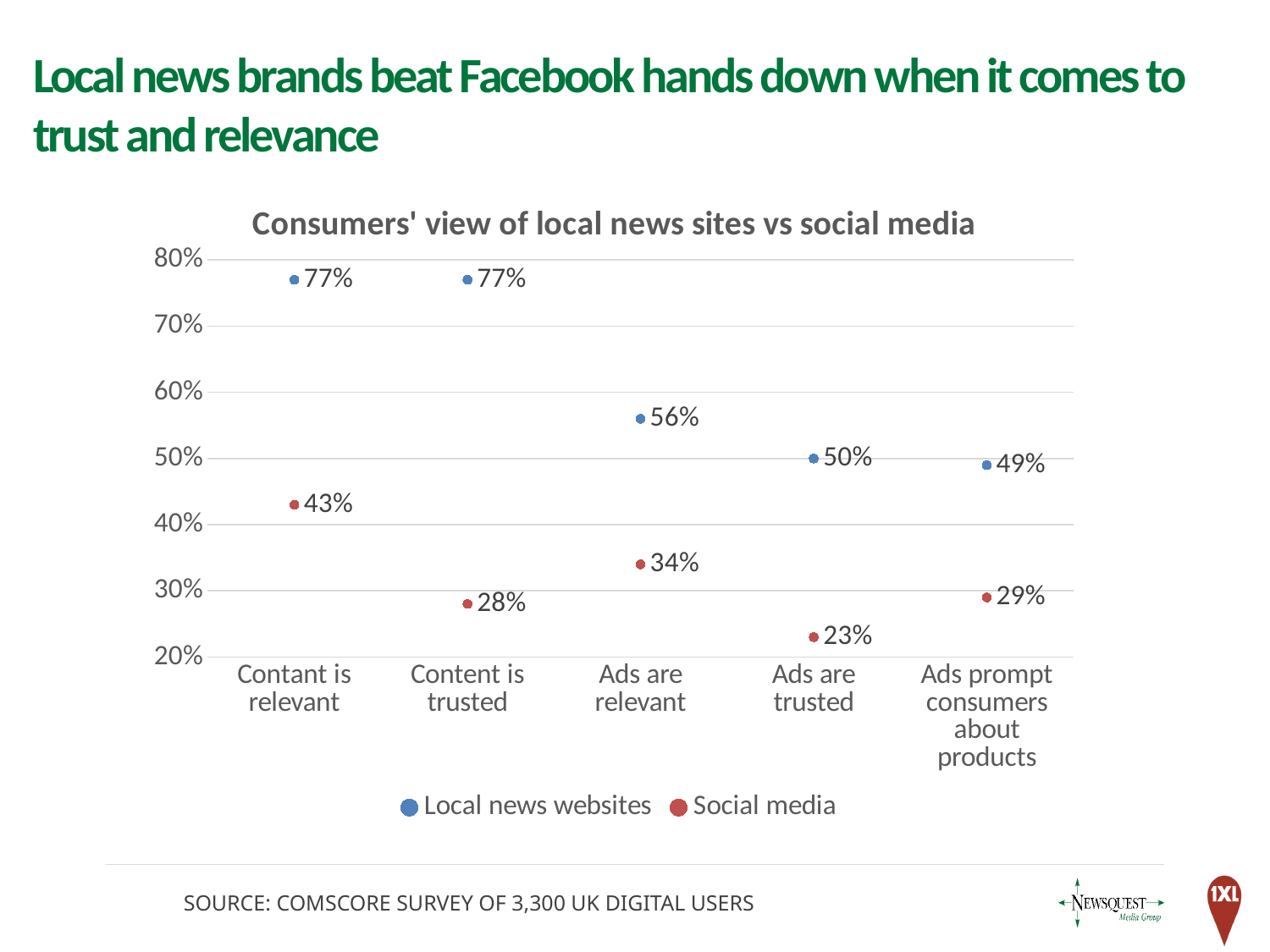
How many categories are shown on the x axis? 5 What is the difference between Local news websites and Social media for 'Content is trusted'? 49% What is the value for Local news websites for 'Ads prompt consumers about products'? 49% What is the title of the chart? Consumers' view of local news sites vs social media What is the value for Local news websites for 'Ads are relevant'? 56% What is the value for Social media for 'Ads are trusted'? 23% Which is larger for 'Ads are relevant': Local news websites or Social media? Local news websites What is the value for Social media for 'Contant is relevant'? 43% How many series does the legend list? 2 Which category has the lowest value for Social media? Ads are trusted What is the difference between Local news websites and Social media for 'Ads are trusted'? 27% Which category has the highest value for Social media? Contant is relevant